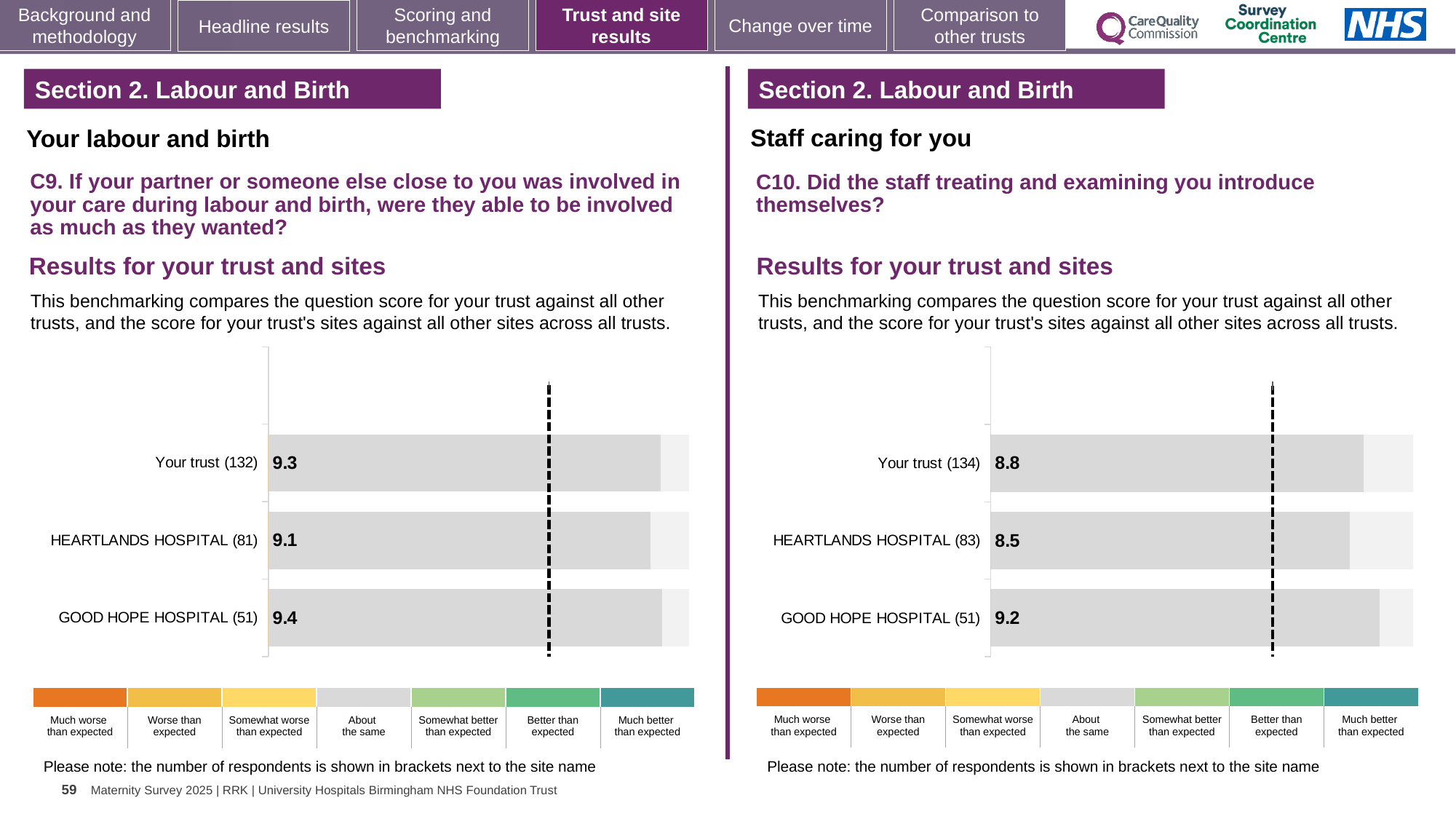
In the C9 chart on the left, what is the score for HEARTLANDS HOSPITAL? 9.1 In the C10 chart on the right, what is the score for GOOD HOPE HOSPITAL? 9.2 In the C10 chart on the right, which has the higher score, Your trust or HEARTLANDS HOSPITAL? Your trust In the C10 chart on the right, what is the score for HEARTLANDS HOSPITAL? 8.5 In the C9 chart on the left, which site or trust has the highest score? GOOD HOPE HOSPITAL How many bars are shown in the C9 chart on the left? 3 In the C9 chart on the left, what is the difference between the scores for GOOD HOPE HOSPITAL and Your trust? 0.1 In the C9 chart on the left, what is the score for Your trust? 9.3 What type of chart is used in the C10 chart on the right? Bar chart In the C10 chart on the right, which site or trust has the lowest score? HEARTLANDS HOSPITAL In the C10 chart on the right, how many respondents are shown in brackets for Your trust? 134 In the C10 chart on the right, what is the difference between the scores for GOOD HOPE HOSPITAL and HEARTLANDS HOSPITAL? 0.7